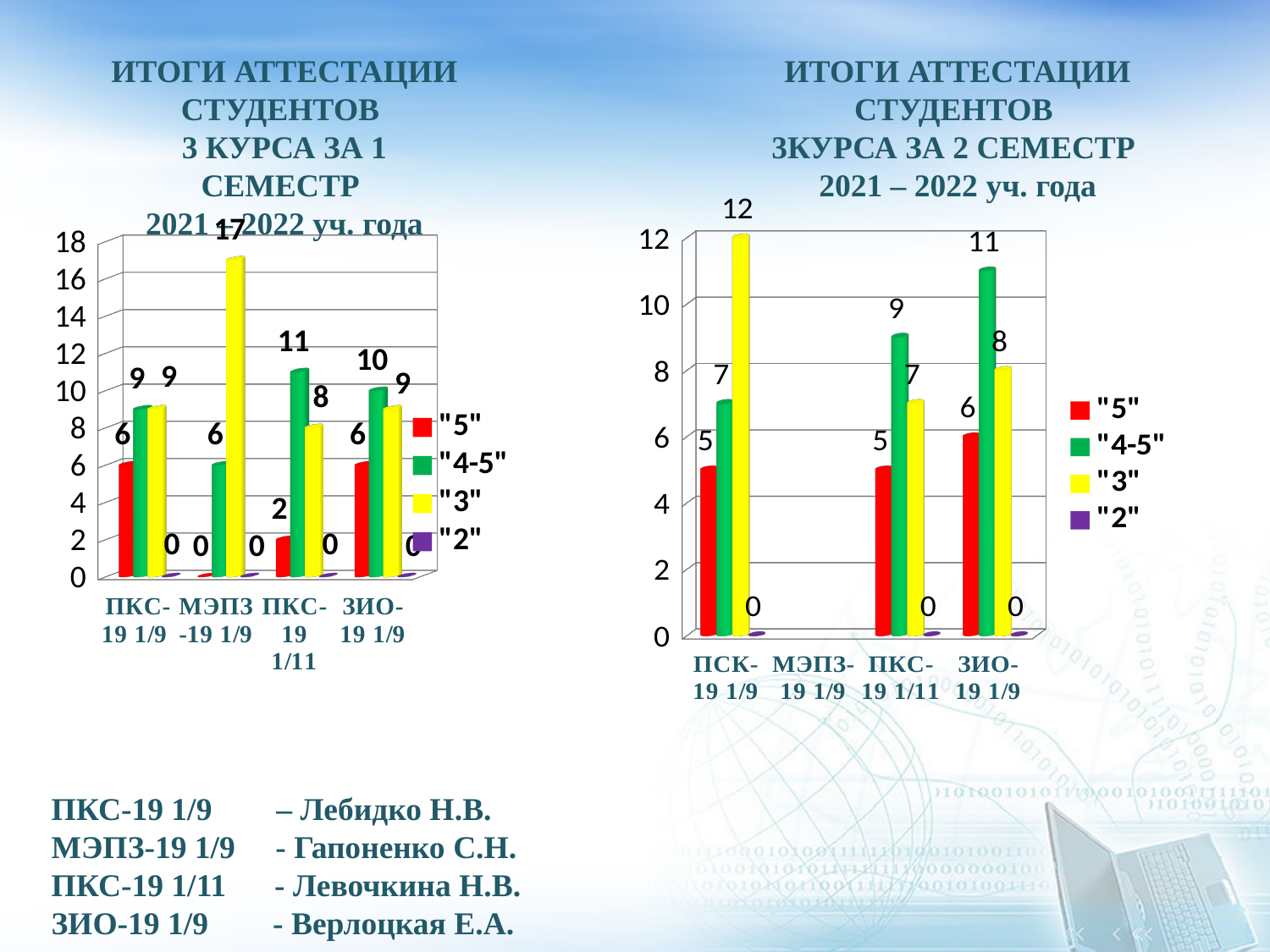
In the right chart (2nd semester), what is the difference between the "3" values for ПСК-19 1/9 and ЗИО-19 1/9? 4 In the right chart (2nd semester), what is the value of the "4-5" series for ЗИО-19 1/9? 11 In the left chart (1st semester), which group has the highest value for the "3" series? МЭПЗ-19 1/9 In the left chart (1st semester), what is the value of the "4-5" series for ПКС-19 1/11? 11 How many series does the legend of the right chart (2nd semester) list? 4 In the left chart (1st semester), which group has the lowest value for the "5" series? МЭПЗ-19 1/9 What type of chart is the left chart (1st semester)? Bar chart In the left chart (1st semester), what is the difference between the "4-5" values for ЗИО-19 1/9 and ПКС-19 1/9? 1 In the left chart (1st semester), what is the value of the "3" series for МЭПЗ-19 1/9? 17 In the right chart (2nd semester), what is the value of the "3" series for ПСК-19 1/9? 12 How many groups are shown on the x axis of the left chart (1st semester)? 4 In the right chart (2nd semester), which is larger for ПКС-19 1/11: the "4-5" value or the "3" value? "4-5"